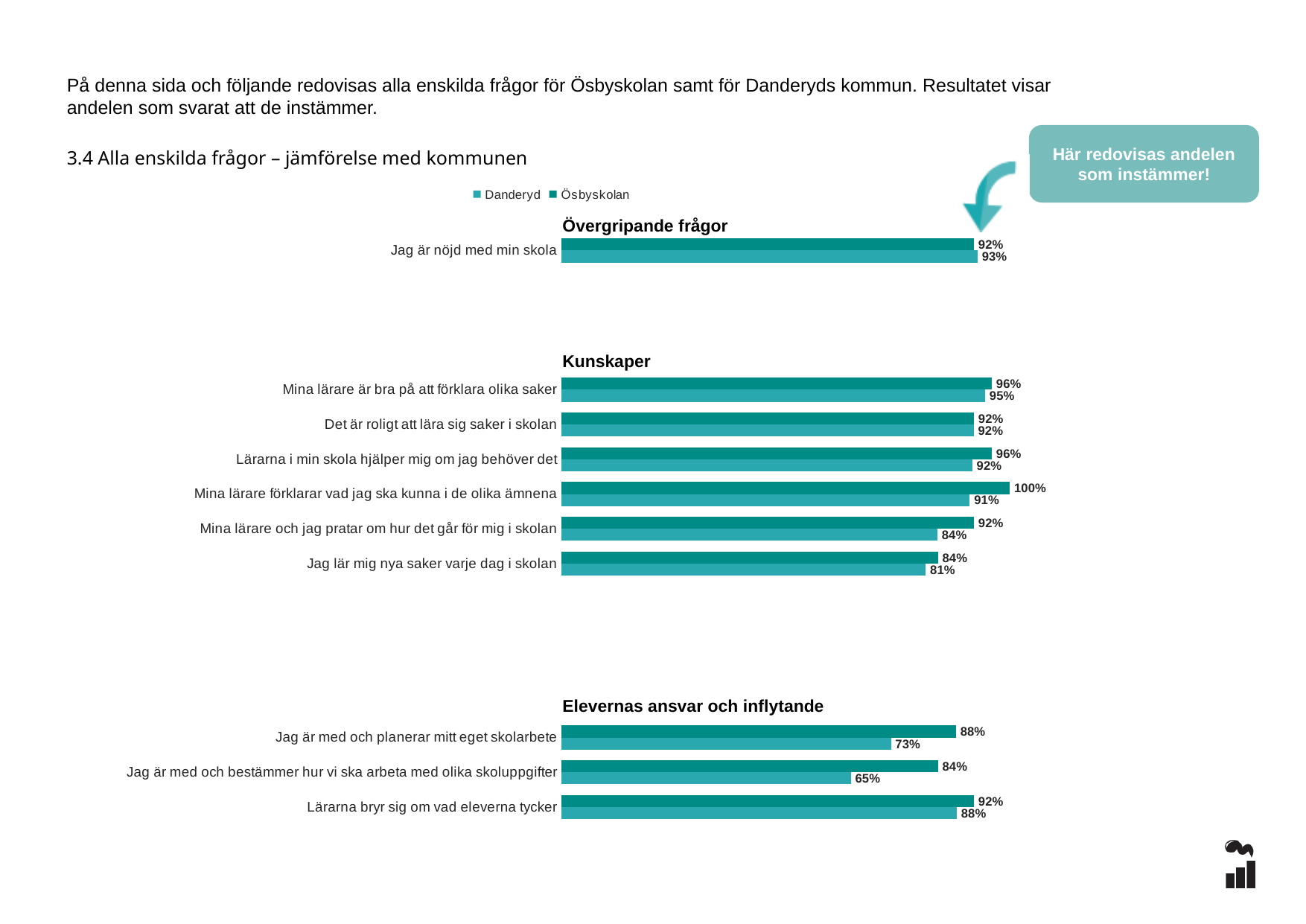
In the 'Kunskaper' chart, which is larger for 'Mina lärare och jag pratar om hur det går för mig i skolan': Ösbyskolan or Danderyd? Ösbyskolan In the 'Elevernas ansvar och inflytande' chart, what is the Danderyd value for 'Jag är med och bestämmer hur vi ska arbeta med olika skoluppgifter'? 65% How many questions are plotted in the 'Elevernas ansvar och inflytande' chart? 3 In the 'Kunskaper' chart, what is the Ösbyskolan value for 'Mina lärare förklarar vad jag ska kunna i de olika ämnena'? 100% How many series does the legend list? 2 What are the two series named in the legend? Danderyd and Ösbyskolan In the 'Kunskaper' chart, which question has the highest Ösbyskolan value? Mina lärare förklarar vad jag ska kunna i de olika ämnena In the 'Kunskaper' chart, which question has the lowest Danderyd value? Jag lär mig nya saker varje dag i skolan How many questions are plotted in the 'Kunskaper' chart? 6 In the 'Elevernas ansvar och inflytande' chart, what is the difference between the Ösbyskolan and Danderyd values for 'Jag är med och planerar mitt eget skolarbete'? 15 percentage points What type of chart is used for the 'Kunskaper' section? Bar chart In the 'Övergripande frågor' chart, what is the Danderyd value for 'Jag är nöjd med min skola'? 93%